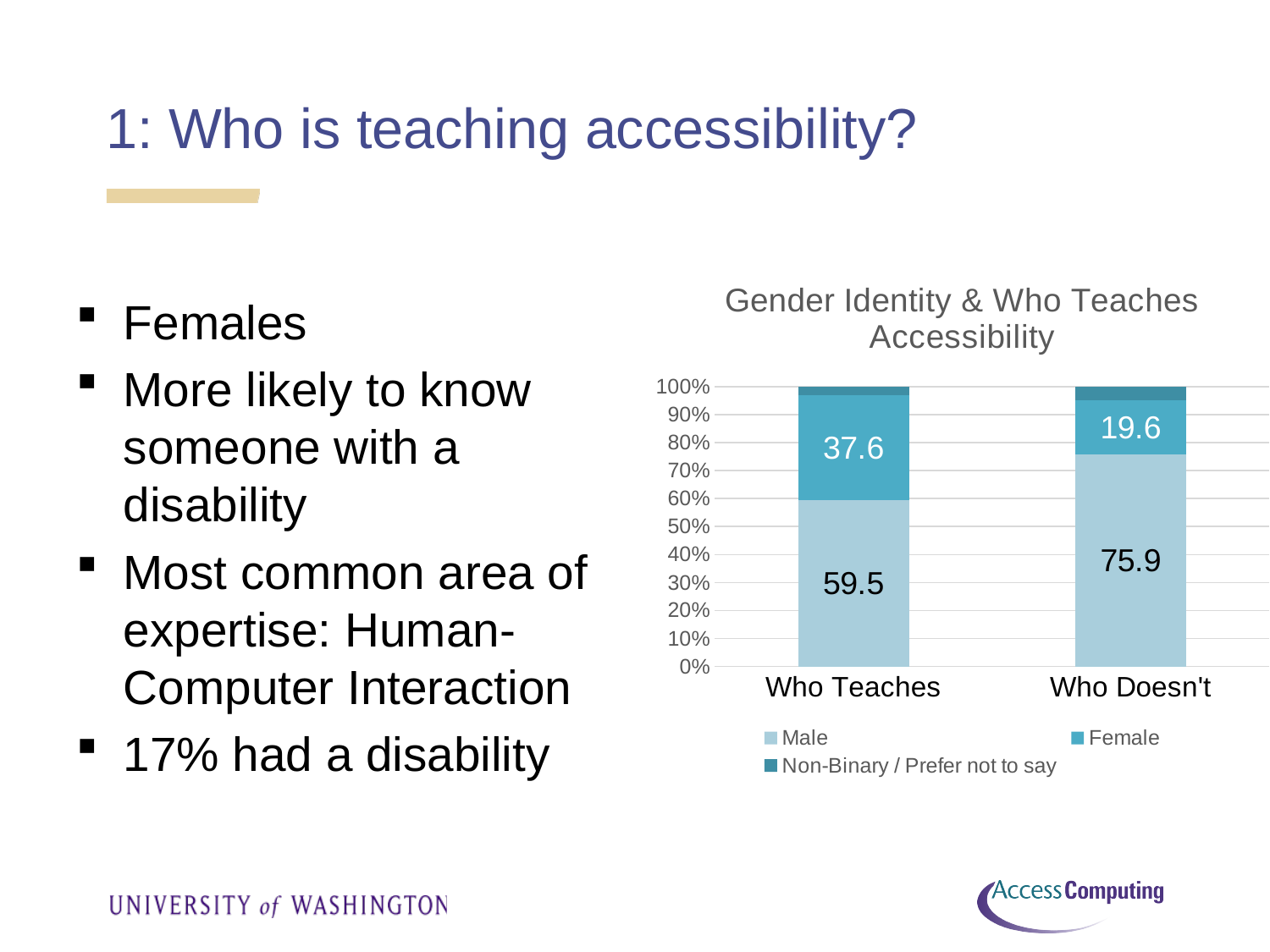
What is the Female value for Who Teaches? 37.6 What is the Male value for Who Doesn't? 75.9 What is the difference between the Male values for Who Doesn't and Who Teaches? 16.4 How many series does the legend list? 3 What is the title of the chart? Gender Identity & Who Teaches Accessibility How many categories are shown on the x axis? 2 Which category has the higher Female value? Who Teaches What is the difference between the Female values for Who Teaches and Who Doesn't? 18.0 What is the Female value for Who Doesn't? 19.6 Is the Female value for Who Doesn't greater or less than 30%? less Which category has the higher Male value, Who Teaches or Who Doesn't? Who Doesn't What is the Male value for Who Teaches? 59.5